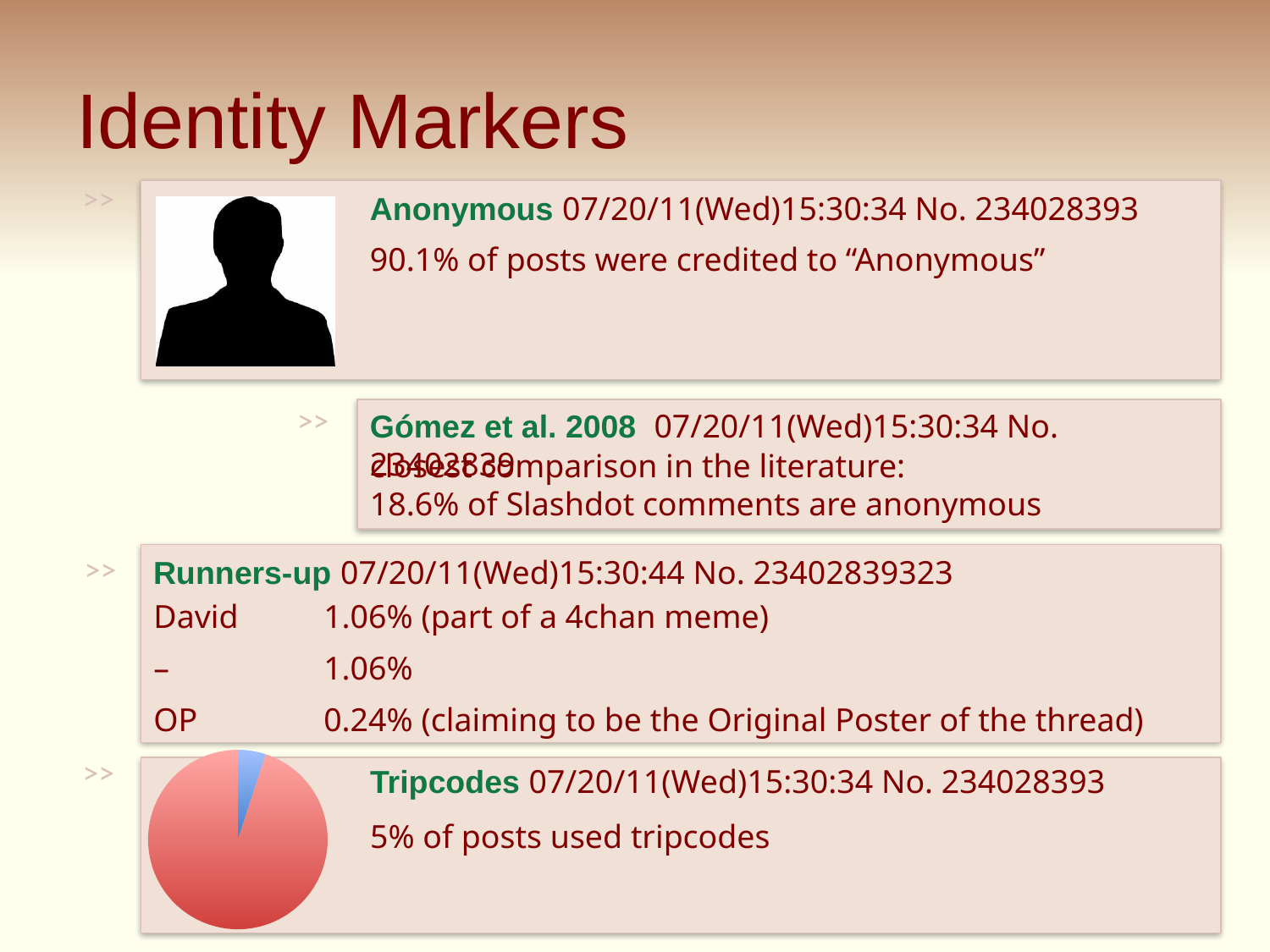
Is the small blue slice of the pie chart in the Tripcodes box greater or less than 50% of the pie? less How many slices does the pie chart in the Tripcodes box have? 2 Does the pie chart in the Tripcodes box have a legend? No In the pie chart in the Tripcodes box, which slice is larger, the red one or the blue one? the red one According to the text next to the pie chart, what share of posts used tripcodes? 5% In the pie chart in the Tripcodes box, which colour slice is the smallest? blue What kind of chart is shown in the Tripcodes box at the bottom of the slide? pie chart